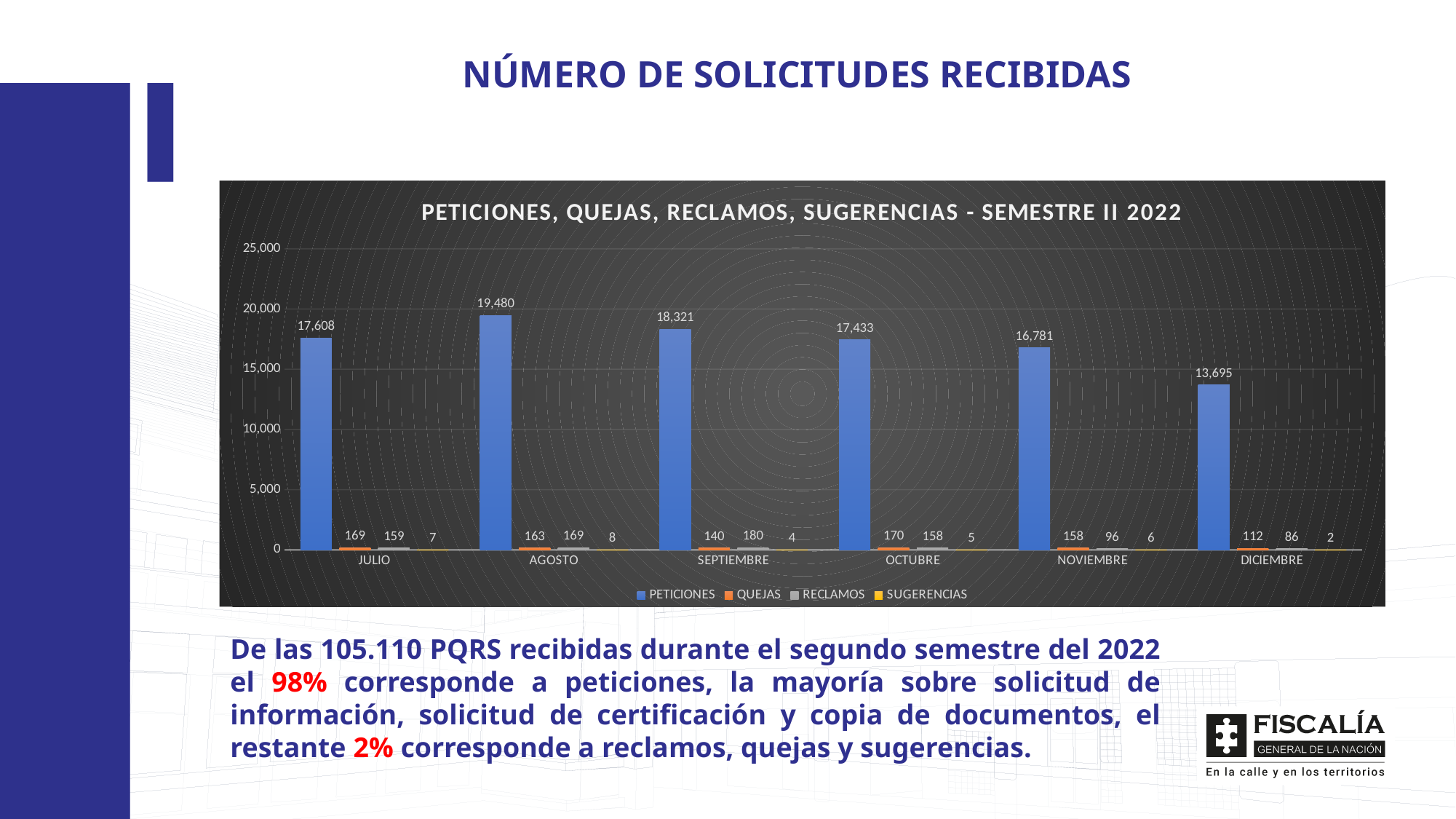
Is the value of PETICIONES for NOVIEMBRE greater or less than 15,000? greater What is the difference between PETICIONES in AGOSTO and PETICIONES in DICIEMBRE? 5,785 What is the value of RECLAMOS for SEPTIEMBRE? 180 Which month has the lowest value for PETICIONES? DICIEMBRE What is the value of PETICIONES for AGOSTO? 19,480 What is the value of SUGERENCIAS for DICIEMBRE? 2 Which is larger: QUEJAS in OCTUBRE or QUEJAS in NOVIEMBRE? QUEJAS in OCTUBRE What kind of chart is shown on the slide? Bar chart How many series does the legend list? 4 What is the title of the chart? PETICIONES, QUEJAS, RECLAMOS, SUGERENCIAS - SEMESTRE II 2022 How many months are shown on the x axis? 6 Which month has the highest value for PETICIONES? AGOSTO